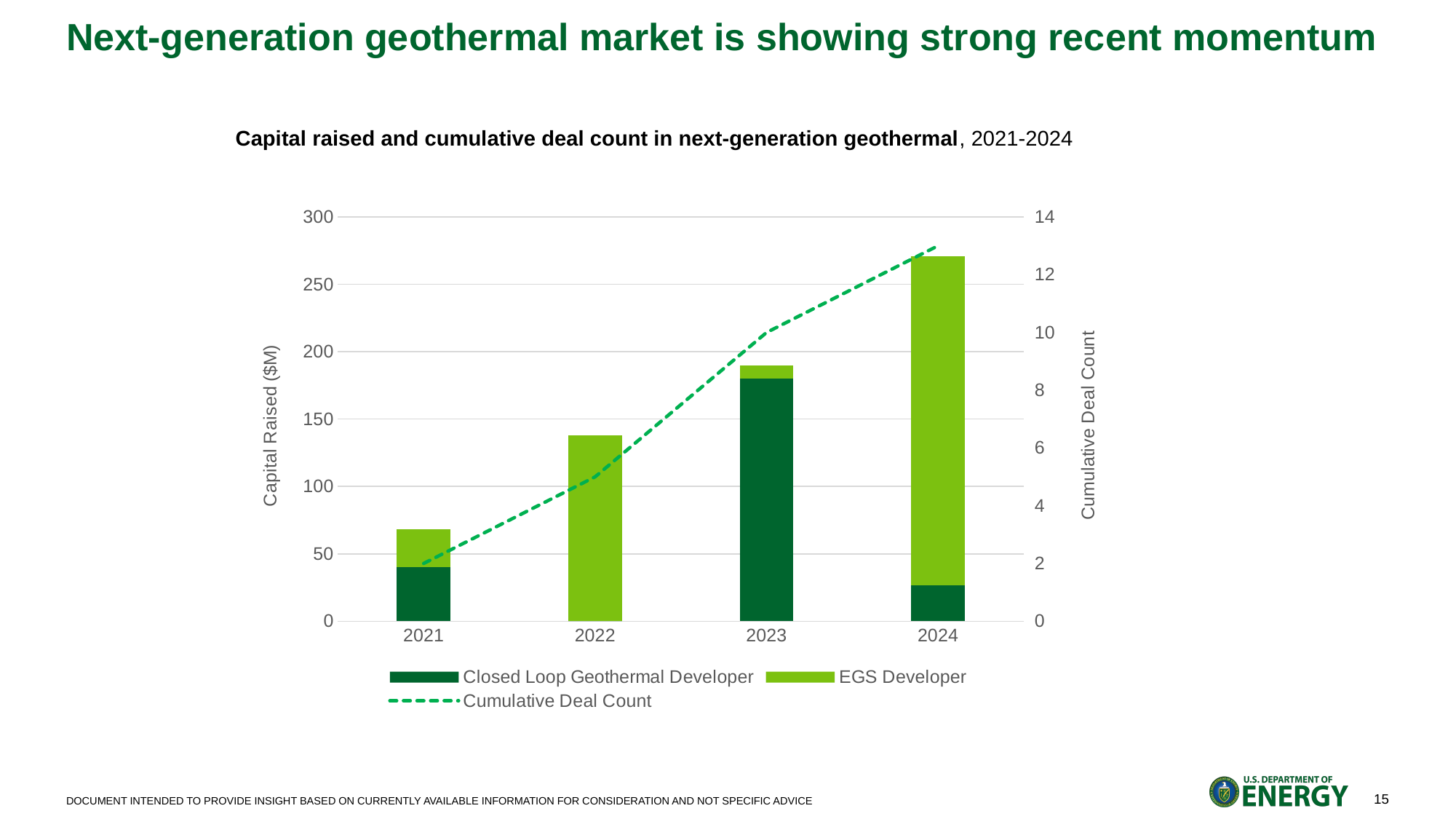
Which year has the shortest total capital raised bar? 2021 Which year has the larger total capital raised bar, 2022 or 2023? 2023 Is the Closed Loop Geothermal Developer value in 2023 greater or less than 150? greater Is the total capital raised in 2024 greater or less than 250? greater Is the total capital raised in 2022 greater or less than 150? less What is the label of the left vertical axis? Capital Raised ($M) What kind of chart is shown on the slide? bar chart with a line How many series does the legend list? 3 How many years are shown on the x axis? 4 Does the Cumulative Deal Count line rise or fall from 2021 to 2024? rise Which year has the tallest total capital raised bar? 2024